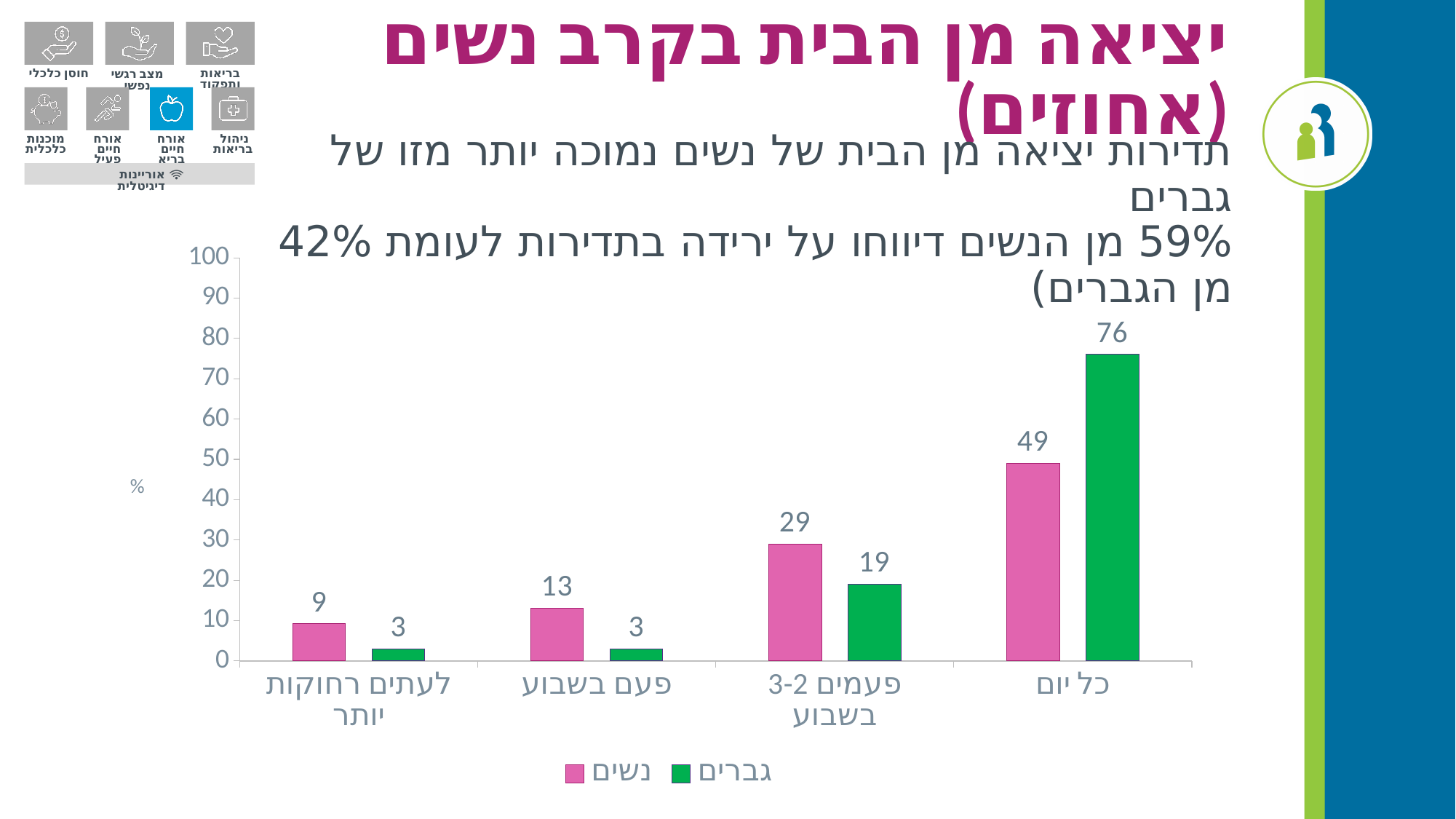
How many series does the legend list? 2 How many categories are shown on the x axis? 4 What is the value for נשים in the כל יום category? 49 In the 2-3 פעמים בשבוע category, which series has the larger value, נשים or גברים? נשים Which colour represents the נשים series? pink Which category has the lowest value for נשים? לעתים רחוקות יותר What is the value for גברים in the כל יום category? 76 What is the difference between גברים and נשים in the כל יום category? 27 What kind of chart is shown on the slide? bar chart Which category has the highest value for גברים? כל יום What is the value for גברים in the פעם בשבוע category? 3 What is the value for נשים in the 2-3 פעמים בשבוע category? 29